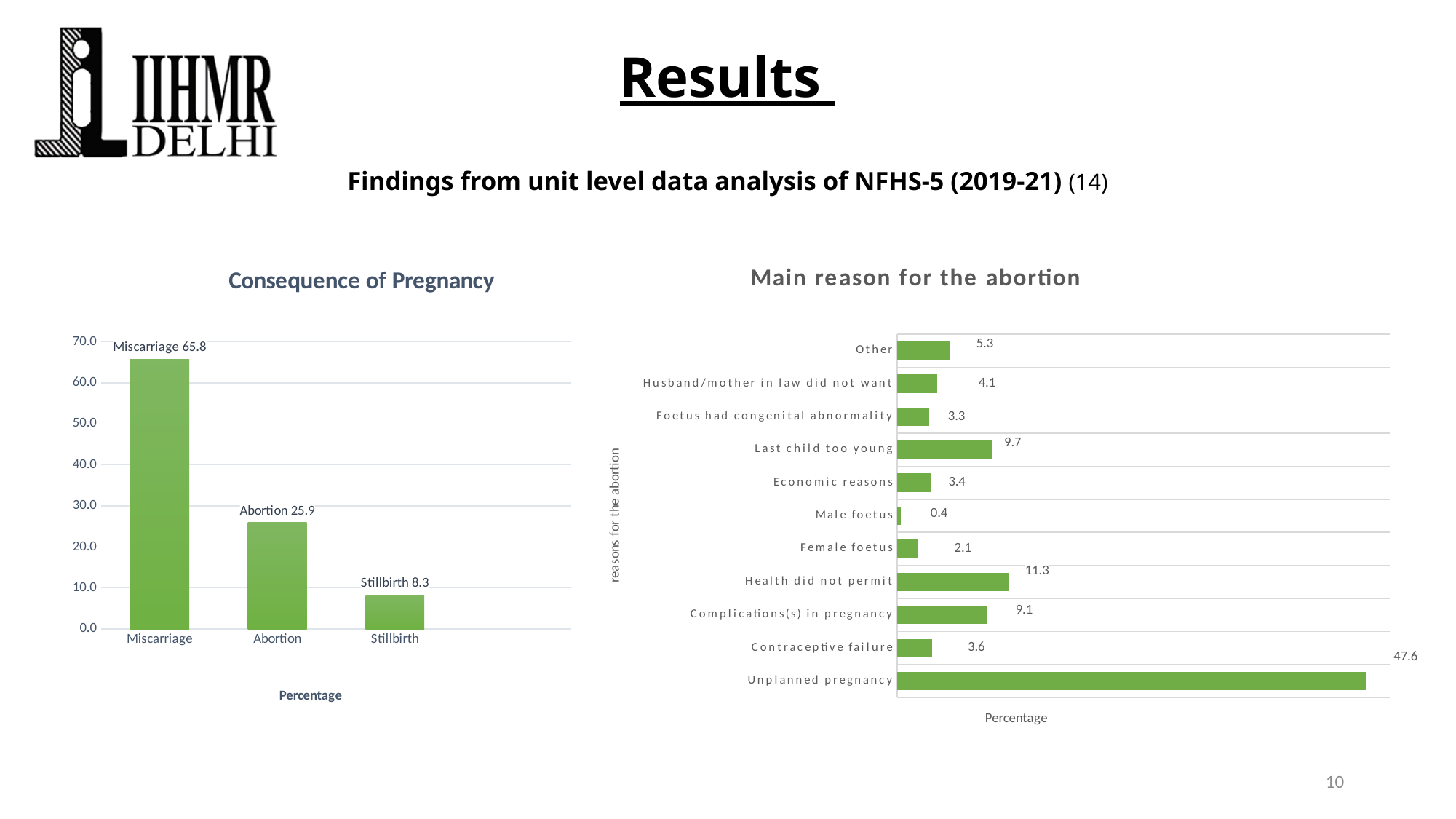
In the 'Consequence of Pregnancy' chart, what is the value for Miscarriage? 65.8 In the 'Consequence of Pregnancy' chart, what is the value for Stillbirth? 8.3 In the 'Main reason for the abortion' chart, which is larger: Last child too young or Complications(s) in pregnancy? Last child too young In the 'Main reason for the abortion' chart, what is the value for Unplanned pregnancy? 47.6 In the 'Main reason for the abortion' chart, what is the difference between Other and Husband/mother in law did not want? 1.2 What type of chart is the 'Main reason for the abortion' chart? Bar chart In the 'Main reason for the abortion' chart, how many reasons are listed? 11 In the 'Consequence of Pregnancy' chart, what is the difference between the Miscarriage and Abortion values? 39.9 In the 'Main reason for the abortion' chart, which reason has the lowest value? Male foetus In the 'Consequence of Pregnancy' chart, how many categories are shown? 3 In the 'Main reason for the abortion' chart, what is the value for Health did not permit? 11.3 In the 'Consequence of Pregnancy' chart, which category has the lowest value? Stillbirth